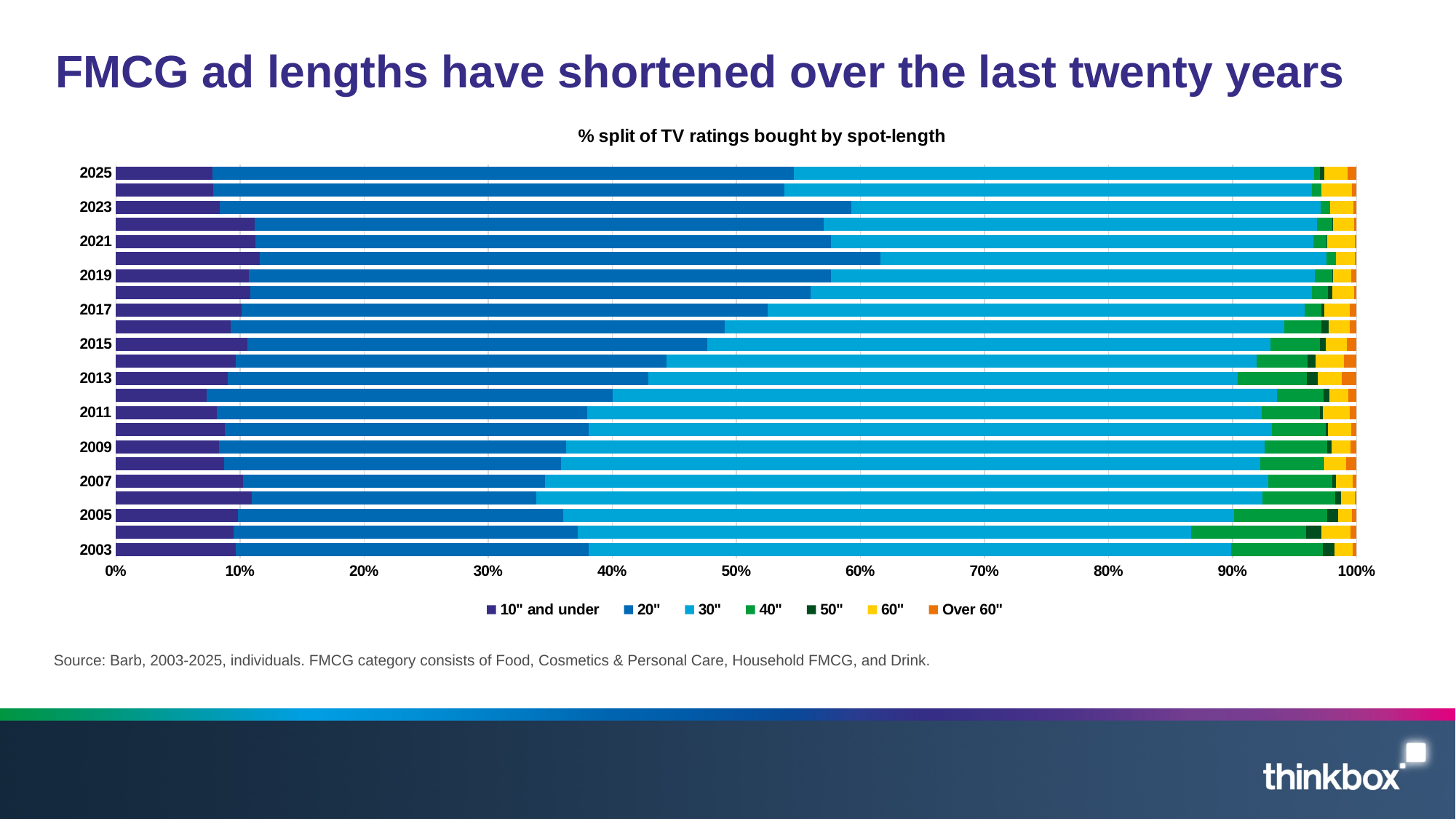
What kind of chart is shown on the slide? Stacked bar chart Which year has the larger 40" segment, 2003 or 2023? 2003 What is the highest value shown on the horizontal axis? 100% Does the share of 20" spots generally rise or fall from 2003 to 2025? rise Which spot-length series is shown in yellow in the legend? 60" Does the share of 40" spots generally rise or fall from 2003 to 2025? fall Which year has the larger 20" segment, 2003 or 2025? 2025 Is the 10" and under segment for 2013 greater or less than 10%? less Is the 10" and under segment for 2025 greater or less than 10%? less Is the 10" and under segment for 2021 greater or less than 10%? greater How many series does the legend list? 7 What is the chart's title? % split of TV ratings bought by spot-length